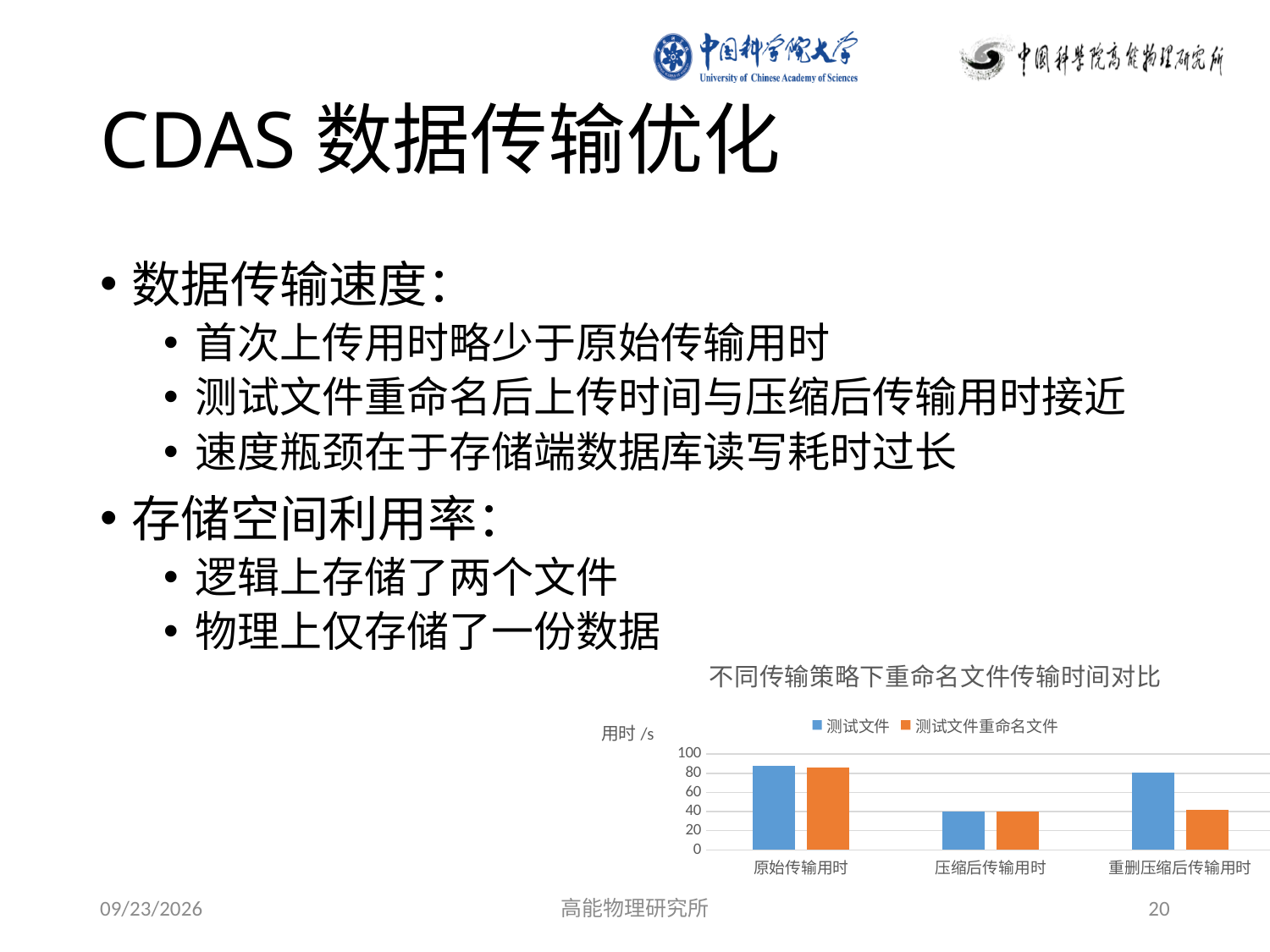
Is the value for 测试文件 at 重删压缩后传输用时 greater or less than 60? greater How many categories are shown on the x axis of the chart? 3 Is the value for 测试文件 at 原始传输用时 greater or less than 80? greater At 重删压缩后传输用时, which series has the larger value, 测试文件 or 测试文件重命名文件? 测试文件 For the 测试文件 series, which category has the lowest value? 压缩后传输用时 For the 测试文件重命名文件 series, which category has the highest value? 原始传输用时 What is the title of the chart? 不同传输策略下重命名文件传输时间对比 Which series is shown in orange in the chart? 测试文件重命名文件 What kind of chart is shown on the slide? bar chart Is the value for 测试文件重命名文件 at 重删压缩后传输用时 greater or less than 60? less How many series does the chart legend list? 2